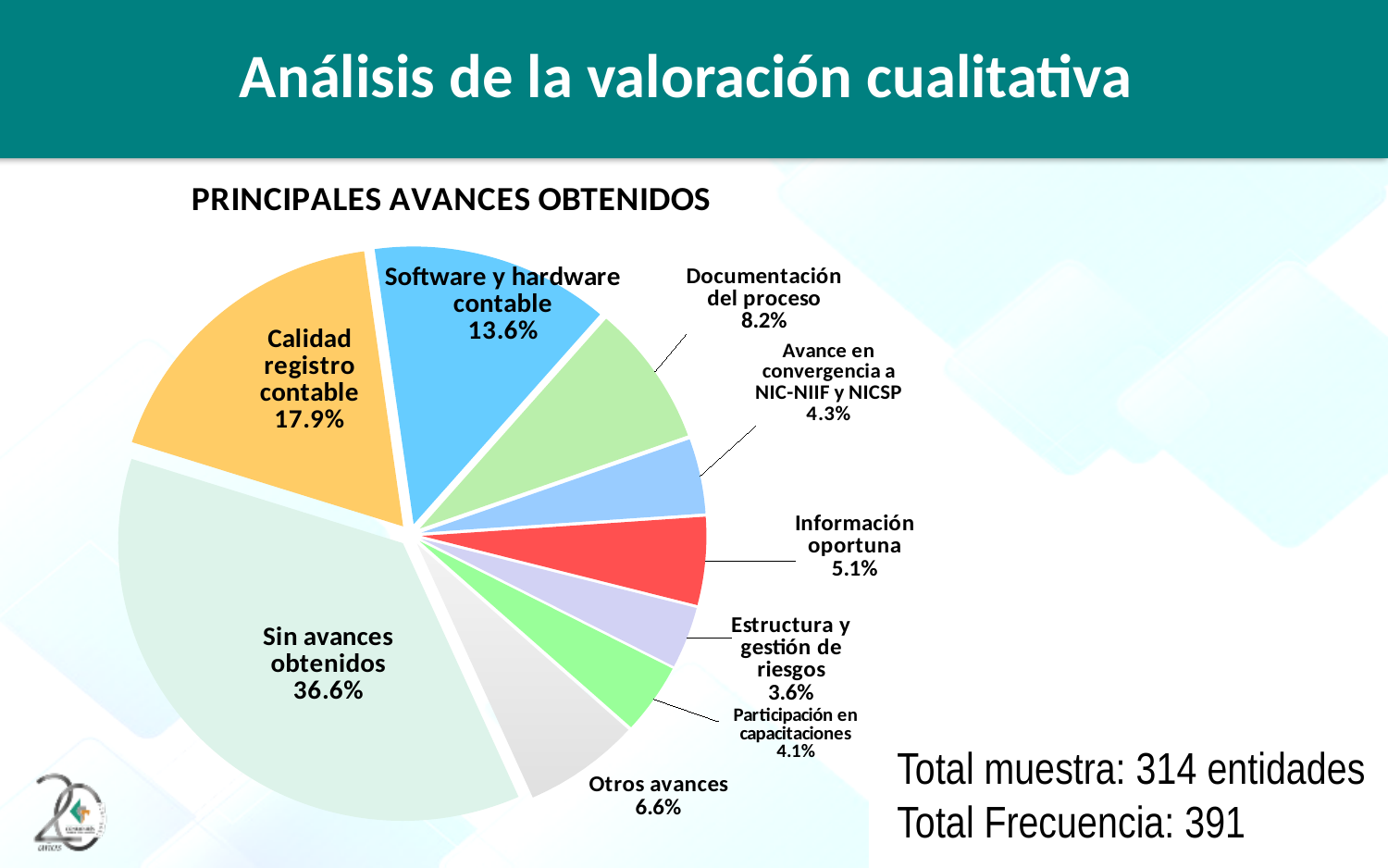
Which category has the largest slice of the pie? Sin avances obtenidos Which is larger, "Información oportuna" or "Avance en convergencia a NIC-NIIF y NICSP"? Información oportuna What kind of chart is shown on the slide? Pie chart Which category has the smallest slice of the pie? Estructura y gestión de riesgos What is the value for "Participación en capacitaciones"? 4.1% What is the value for "Documentación del proceso"? 8.2% What is the difference between "Calidad registro contable" and "Software y hardware contable"? 4.3% What is the value for "Software y hardware contable"? 13.6% What is the title of the chart? PRINCIPALES AVANCES OBTENIDOS How many slices does the pie chart have? 9 What share of the pie does "Sin avances obtenidos" represent? 36.6% What is the value for "Calidad registro contable"? 17.9%